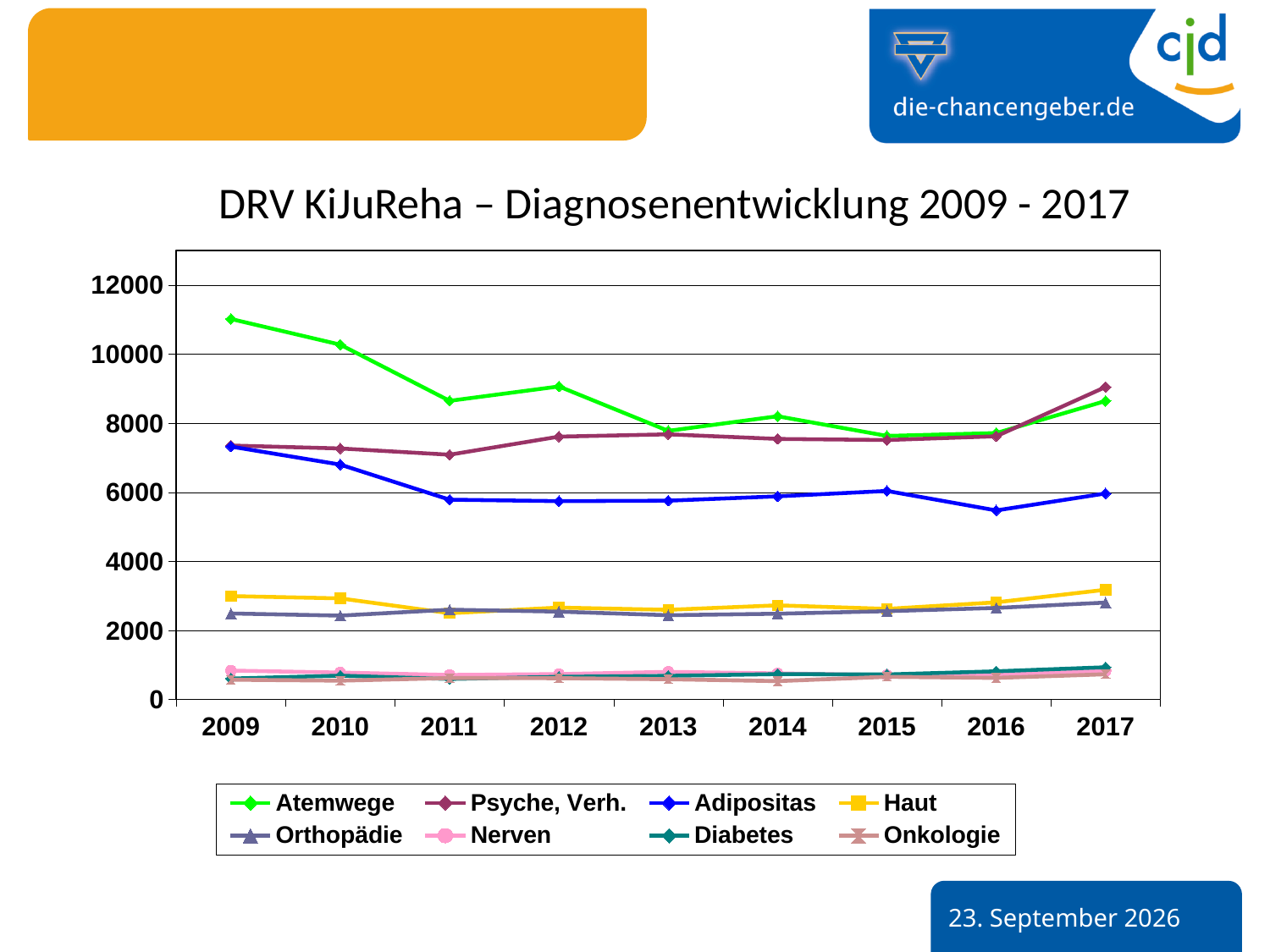
Is the value for Adipositas in 2016 greater or less than 6000? less Is the value for Atemwege in 2011 greater or less than 10000? less How many series does the legend list? 8 What is the title of the chart? DRV KiJuReha – Diagnosenentwicklung 2009 - 2017 Is the value for Atemwege in 2009 greater or less than 10000? greater Which series has the highest value in 2009? Atemwege Which is larger in 2010, Atemwege or Adipositas? Atemwege Which series has the highest value in 2017? Psyche, Verh. Does the Atemwege series rise or fall from 2009 to 2013? fall What kind of chart is shown on the slide? line chart Which is larger in 2009, Haut or Orthopädie? Haut How many years are shown on the x axis? 9